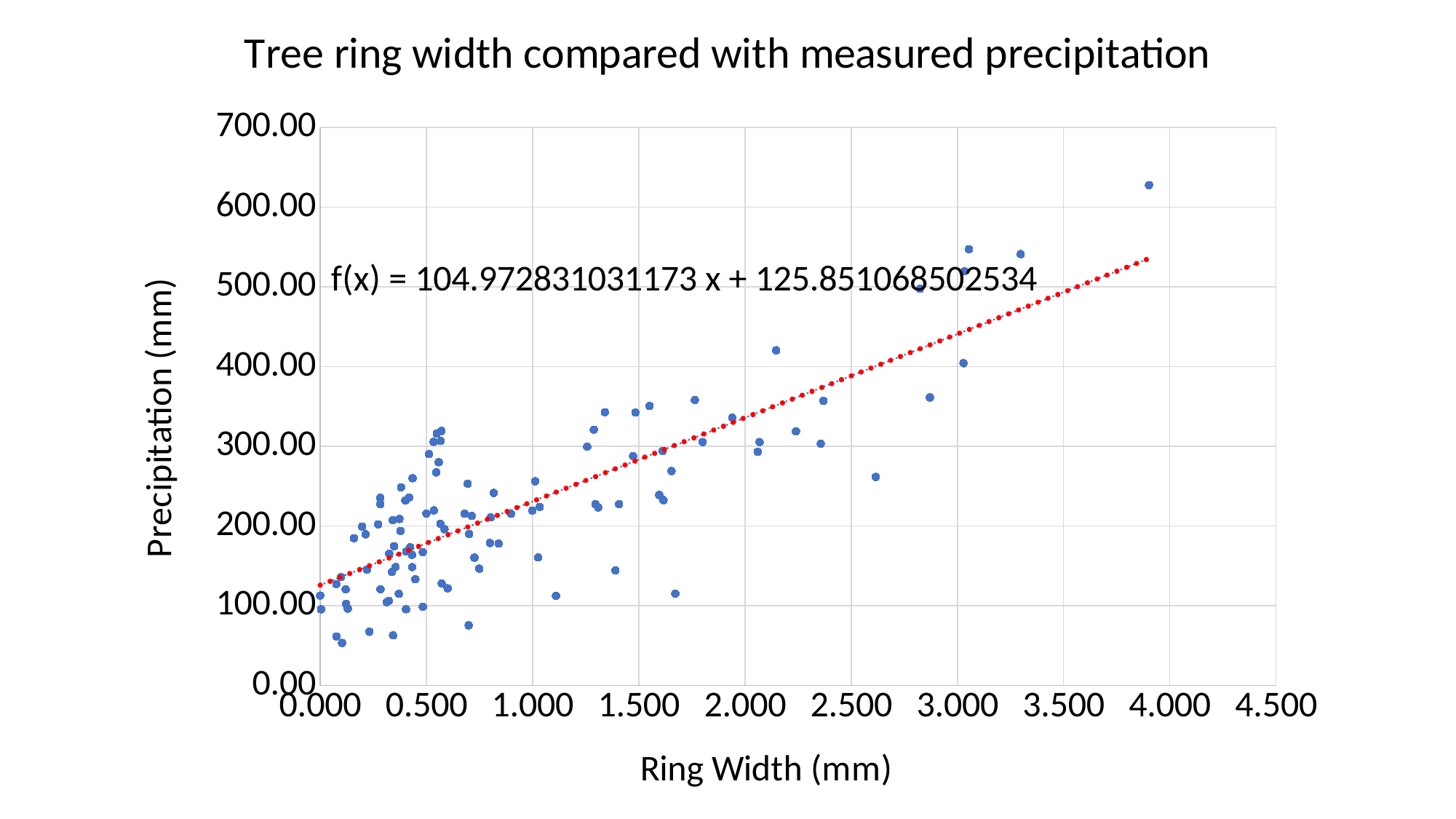
What kind of chart is shown on the slide? Scatter plot What is the intercept of the trendline shown in the printed equation? 125.851068502534 What is the slope of the trendline shown in the printed equation? 104.972831031173 Does precipitation generally rise or fall as ring width increases along the x axis? Rise What is the title of the chart? Tree ring width compared with measured precipitation What is the label of the x axis? Ring Width (mm) What is the maximum value shown on the y axis? 700.00 Is the precipitation value of the point with the largest ring width greater or less than 600? greater Is the ring width of the point with the highest precipitation greater or less than 3.500? greater What is the equation of the trendline printed on the chart? f(x) = 104.972831031173 x + 125.851068502534 Is the lowest precipitation value plotted greater or less than 100? less